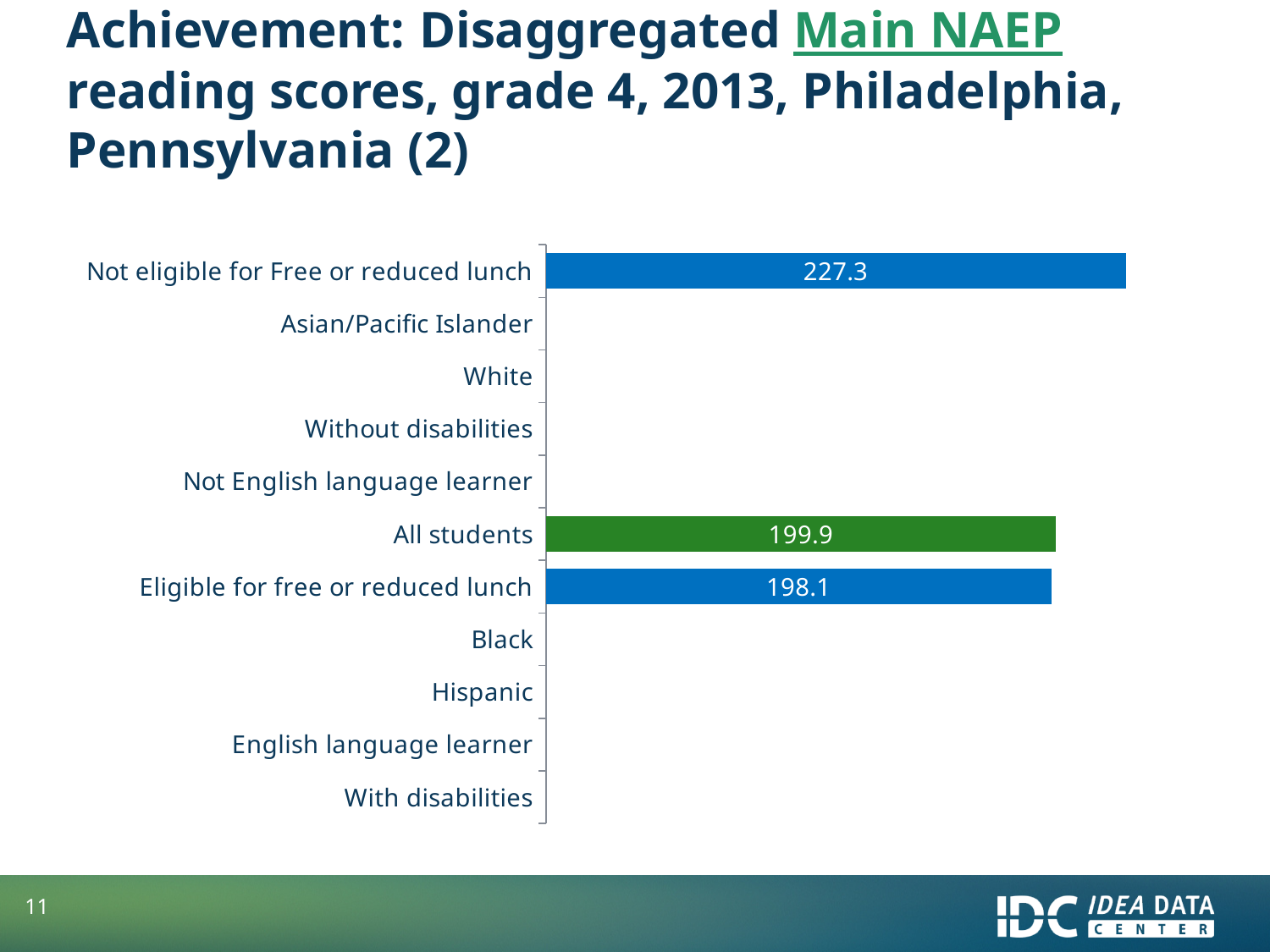
What is the value for Eligible for free or reduced lunch? 198.1 Which category has the highest plotted value? Not eligible for Free or reduced lunch What is the value for All students? 199.9 Which of the plotted categories has the lowest value? Eligible for free or reduced lunch What kind of chart is shown on the slide? Bar chart What is the value for Not eligible for Free or reduced lunch? 227.3 How many category labels are listed on the vertical axis? 11 Which is larger, the value for All students or the value for Eligible for free or reduced lunch? All students What colour is the bar for All students? Green What is the difference between the values for All students and Eligible for free or reduced lunch? 1.8 How many categories have a bar with a data label shown? 3 What is the difference between the values for Not eligible for Free or reduced lunch and Eligible for free or reduced lunch? 29.2